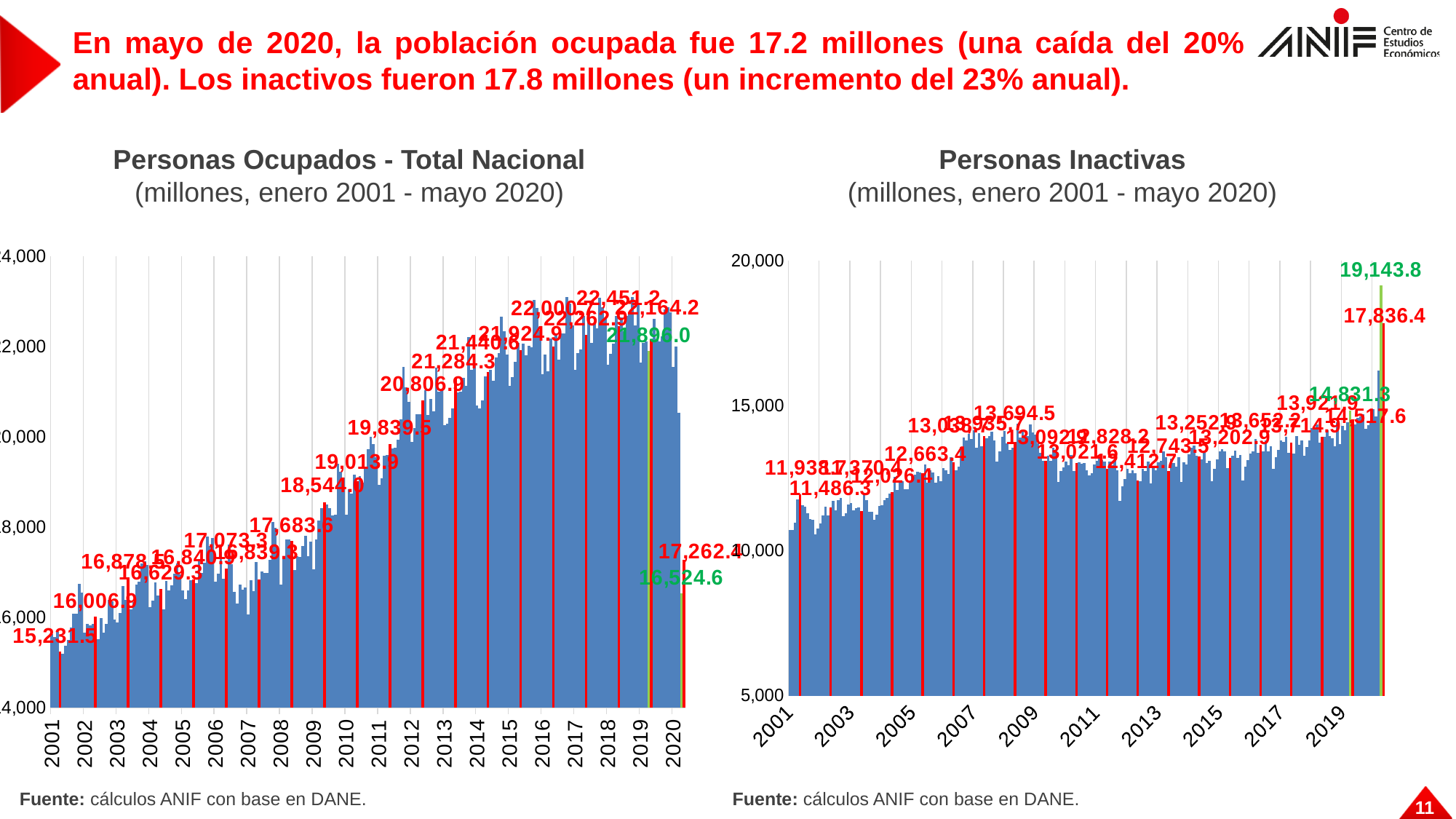
In the 'Personas Inactivas' chart, what is the difference between the green label 19,143.8 and the red label 17,836.4? 1,307.4 In the 'Personas Ocupados - Total Nacional' chart, what is the red labeled value for May 2020? 17,262.4 What kind of chart is the 'Personas Ocupados - Total Nacional' chart? bar chart In the 'Personas Ocupados - Total Nacional' chart, which labeled value is larger: the 2001 label or the 2002 label? 2002 (16,006.9) In the 'Personas Ocupados - Total Nacional' chart, what is the difference between the highest labeled value (22,451.2) and the May 2020 value (17,262.4)? 5,188.8 In the 'Personas Ocupados - Total Nacional' chart, what is the first labeled value, at 2001? 15,231.5 In the 'Personas Inactivas' chart, is the value of the first bar in 2001 greater or less than 15,000? less How many charts are shown on the slide? 2 In the 'Personas Ocupados - Total Nacional' chart, what is the lowest labeled value? 15,231.5 In the 'Personas Ocupados - Total Nacional' chart, what is the highest labeled value? 22,451.2 In the 'Personas Inactivas' chart, what is the highest labeled value? 19,143.8 In the 'Personas Inactivas' chart, what is the red labeled value for May 2020? 17,836.4